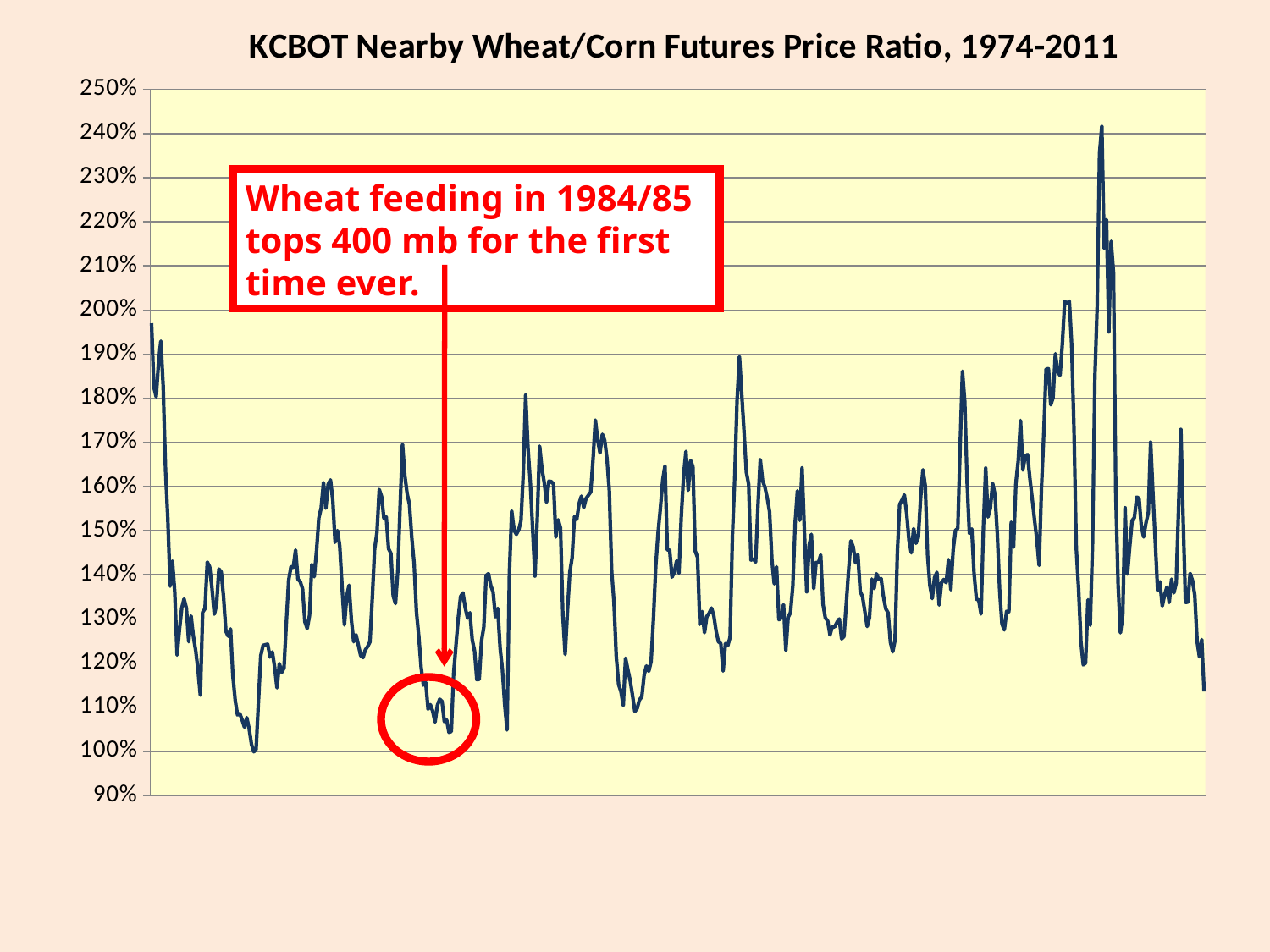
What is the highest value shown on the y axis of the chart? 250% What is the lowest value shown on the y axis of the chart? 90% What does the red annotation box on the chart say? Wheat feeding in 1984/85 tops 400 mb for the first time ever. Is the value of the line in the red-circled region greater or less than 120%? less Is the value at the far right end of the line greater or less than 130%? less What kind of chart is shown on the slide? line chart What is the title of the chart? KCBOT Nearby Wheat/Corn Futures Price Ratio, 1974-2011 Which is larger: the highest peak near the right side of the chart or the peak at the far left start of the line? the peak near the right side